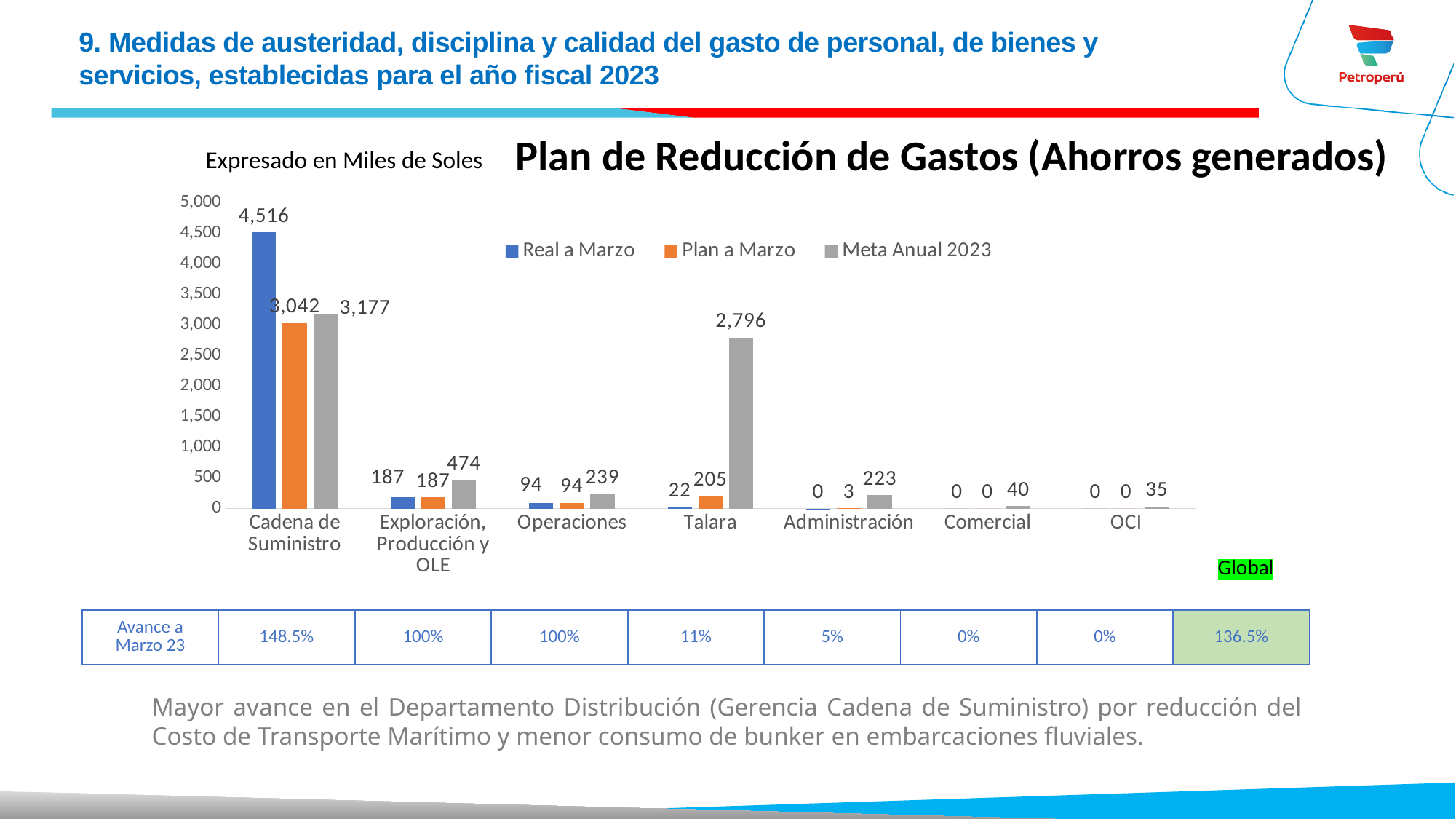
What is the Meta Anual 2023 value for Talara? 2,796 What type of chart is shown on the slide? Bar chart What is the title of the chart? Plan de Reducción de Gastos (Ahorros generados) Which category has the lowest Meta Anual 2023 value? OCI Which category has the highest Meta Anual 2023 value? Cadena de Suministro How many series does the chart legend list? 3 What is the Meta Anual 2023 value for Exploración, Producción y OLE? 474 What is the Plan a Marzo value for Administración? 3 Which is larger for Talara: the Real a Marzo value or the Plan a Marzo value? Plan a Marzo What is the difference between the Real a Marzo and Plan a Marzo values for Cadena de Suministro? 1,474 What is the Real a Marzo value for Cadena de Suministro? 4,516 How many categories are shown on the x axis of the chart? 7